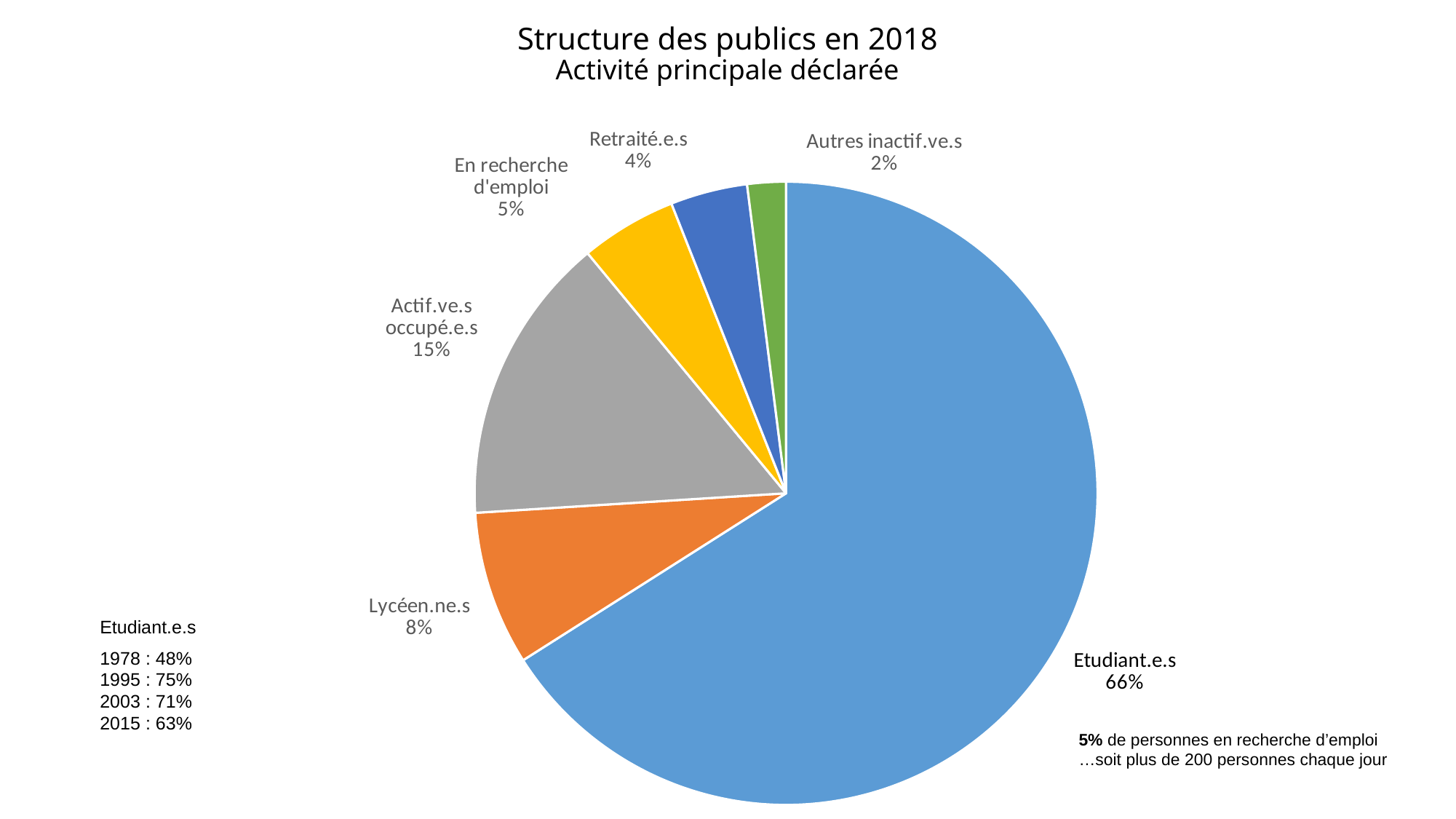
How many categories are shown in the pie chart? 6 Which category has the smallest slice of the pie? Autres inactif.ve.s What is the value shown for Actif.ve.s occupé.e.s? 15% Which category has the largest slice of the pie? Etudiant.e.s What is the difference between the shares of Actif.ve.s occupé.e.s and Lycéen.ne.s? 7% What kind of chart is shown on the slide? Pie chart What colour is the Etudiant.e.s slice? Blue Which is larger, the share for En recherche d'emploi or the share for Retraité.e.s? En recherche d'emploi What share of the pie does Etudiant.e.s represent? 66% What is the value shown for Retraité.e.s? 4% What is the title of the chart? Structure des publics en 2018 Activité principale déclarée What is the value shown for Lycéen.ne.s? 8%